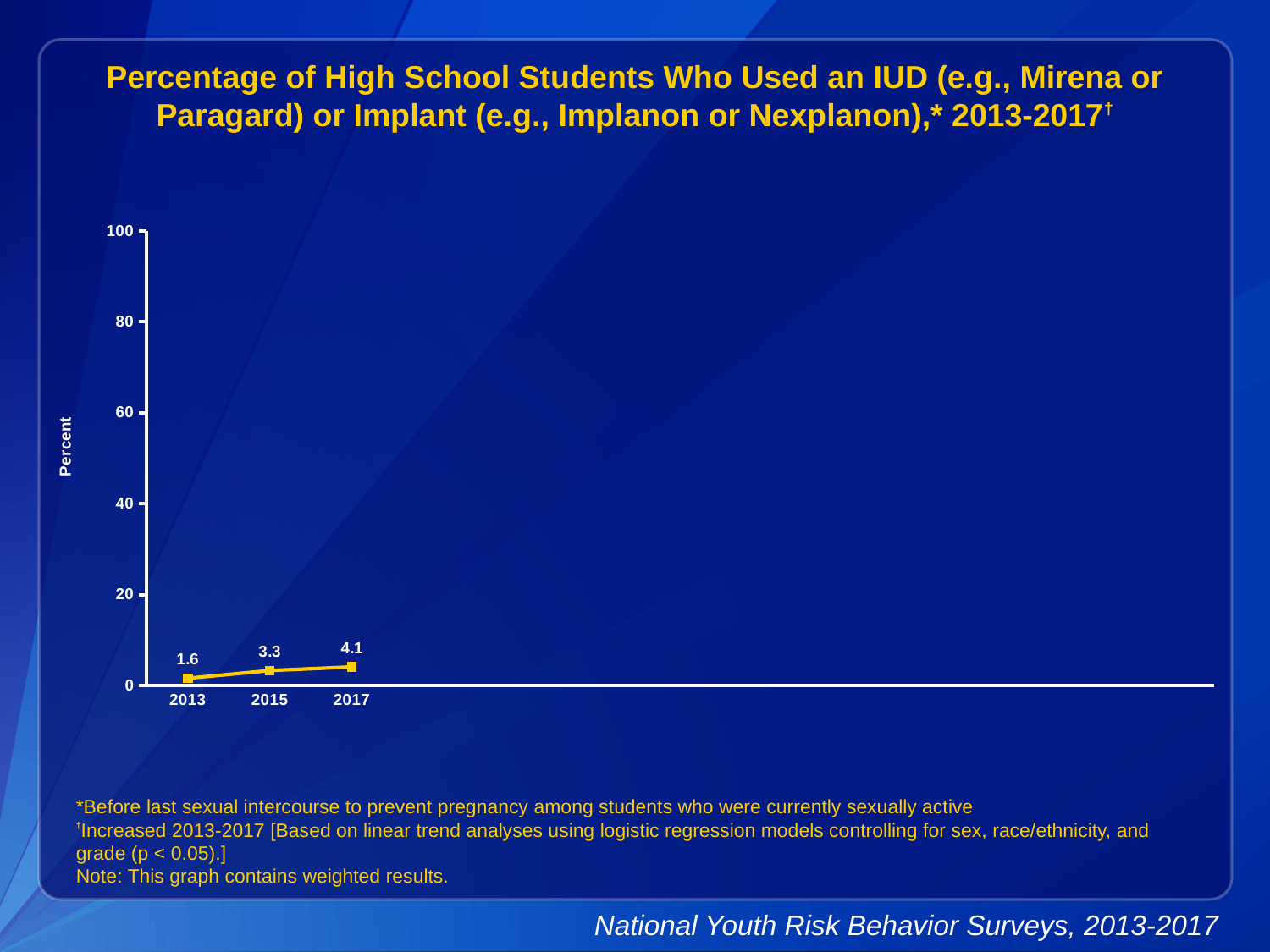
Is the value for 2017 greater or less than 20? less What percentage of high school students used an IUD or implant in 2015? 3.3 What percentage of high school students used an IUD or implant in 2017? 4.1 Which year has a larger value, 2015 or 2017? 2017 How many years are plotted on the chart? 3 What percentage of high school students used an IUD or implant in 2013? 1.6 What kind of chart is shown on the slide? line chart Which year has the lowest percentage of students who used an IUD or implant? 2013 What is the difference between the 2015 and 2013 values? 1.7 What is the difference between the 2017 and 2013 values? 2.5 Which year has the highest percentage of students who used an IUD or implant? 2017 Do the values rise or fall from 2013 to 2017? rise